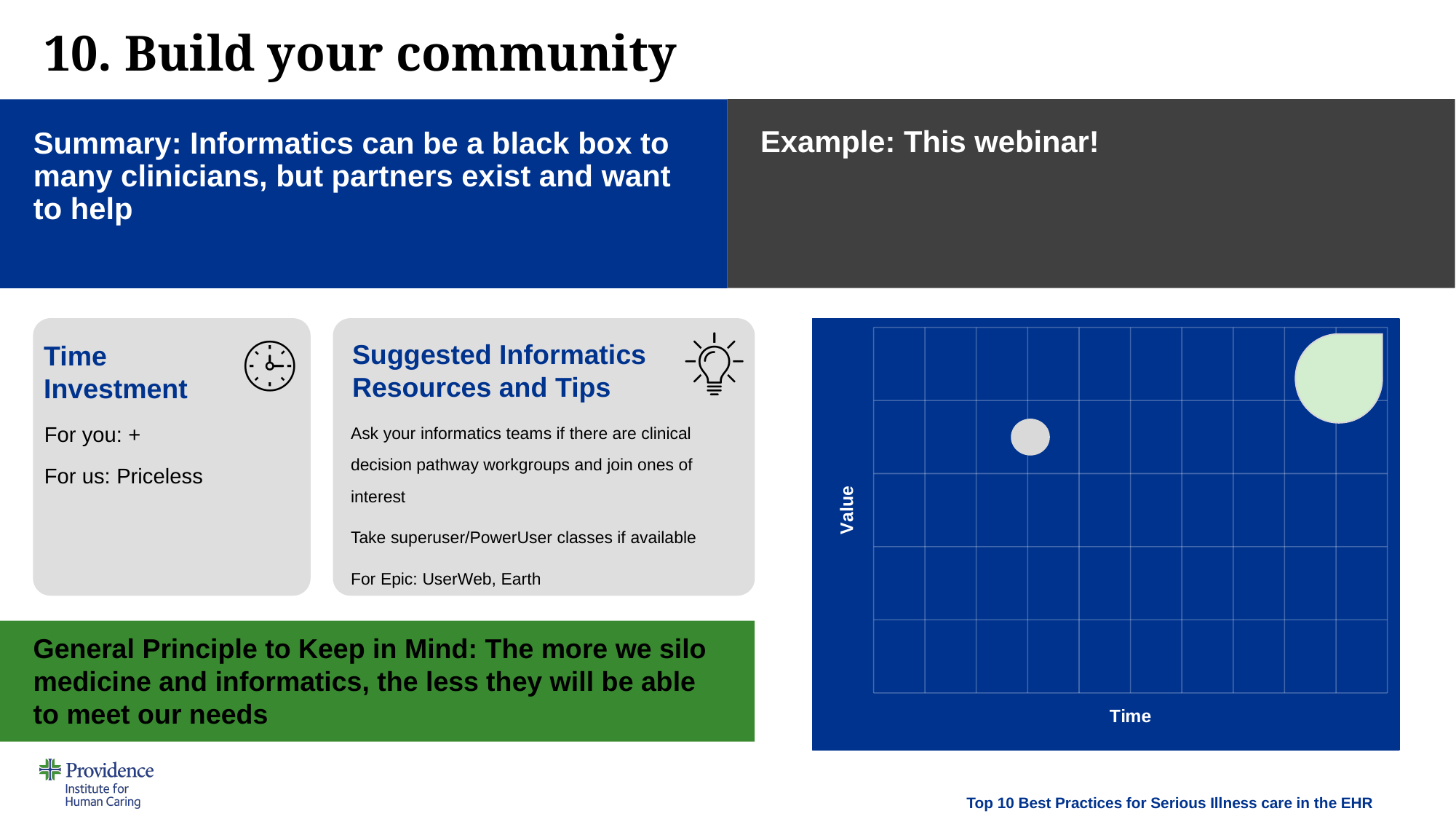
How many data points are plotted on the chart? 2 Which plotted point is larger in size, the grey one or the green one? the green one Do the plotted values rise or fall as you move along the Time axis? rise What kind of chart is shown on the right side of the slide? bubble chart What is the label of the horizontal axis of the chart? Time What is the label of the vertical axis of the chart? Value Which plotted point has the higher Value, the grey one or the green one? the green one Which plotted point is further along the Time axis, the grey one or the green one? the green one